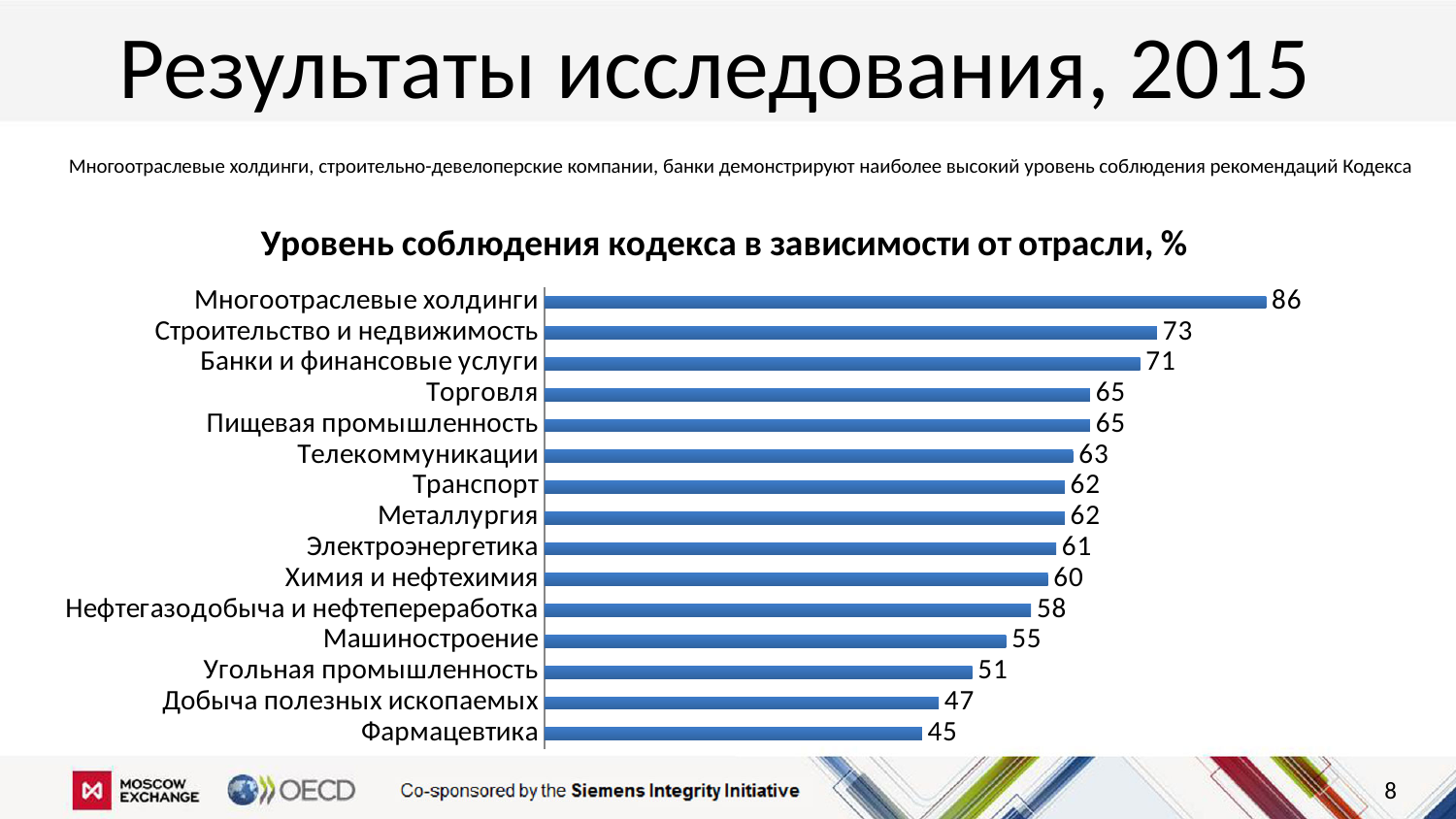
Which is larger, the value for Машиностроение or the value for Угольная промышленность? Машиностроение What is the value for Телекоммуникации? 63 What is the value for Многоотраслевые холдинги? 86 What is the value for Нефтегазодобыча и нефтепереработка? 58 Which category has the highest value? Многоотраслевые холдинги What kind of chart is shown on the slide? Bar chart What is the value for Фармацевтика? 45 What is the difference between the values for Многоотраслевые холдинги and Фармацевтика? 41 How many categories are shown in the chart? 15 What is the title of the chart? Уровень соблюдения кодекса в зависимости от отрасли, % Which category has the lowest value? Фармацевтика What is the difference between the values for Строительство и недвижимость and Банки и финансовые услуги? 2